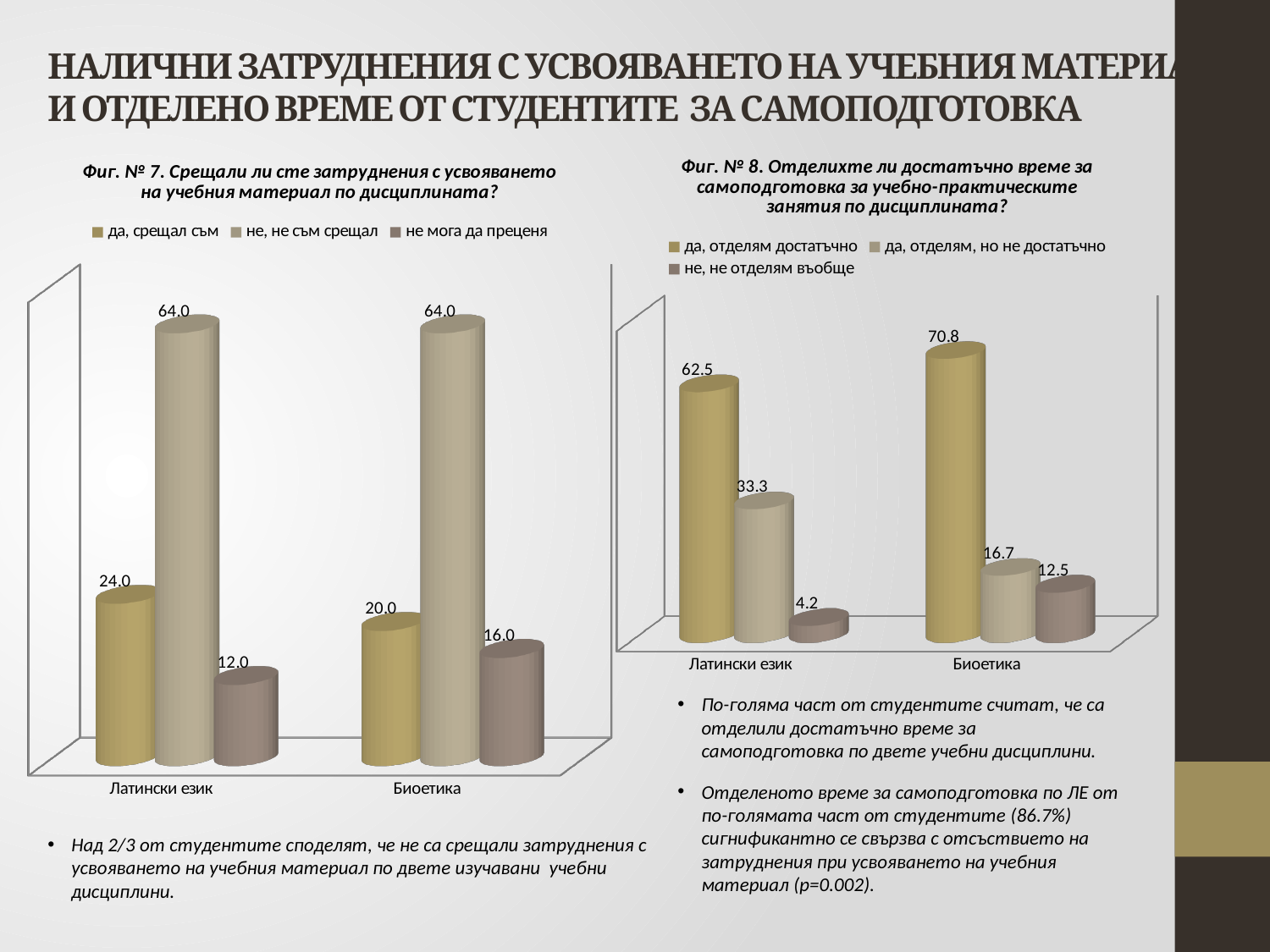
In the chart Фиг. № 8, what is the value for 'да, отделям достатъчно' for Биоетика? 70.8 In the chart Фиг. № 8, which is larger for Биоетика: 'да, отделям, но не достатъчно' or 'не, не отделям въобще'? да, отделям, но не достатъчно What type of chart is Фиг. № 8? bar chart In the chart Фиг. № 7, what is the value for 'не мога да преценя' for Биоетика? 16.0 In the chart Фиг. № 7, what is the value for 'да, срещал съм' for Латински език? 24.0 In the chart Фиг. № 7, what is the difference between 'не, не съм срещал' and 'да, срещал съм' for Латински език? 40.0 In the chart Фиг. № 8, what is the value for 'не, не отделям въобще' for Латински език? 4.2 In the chart Фиг. № 7, which series has the highest value for Биоетика? не, не съм срещал In the chart Фиг. № 7, how many series does the legend list? 3 In the chart Фиг. № 8, which series has the lowest value for Латински език? не, не отделям въобще In the chart Фиг. № 8, what is the difference between 'да, отделям достатъчно' for Биоетика and for Латински език? 8.3 In the chart Фиг. № 8, how many categories are shown on the x axis? 2